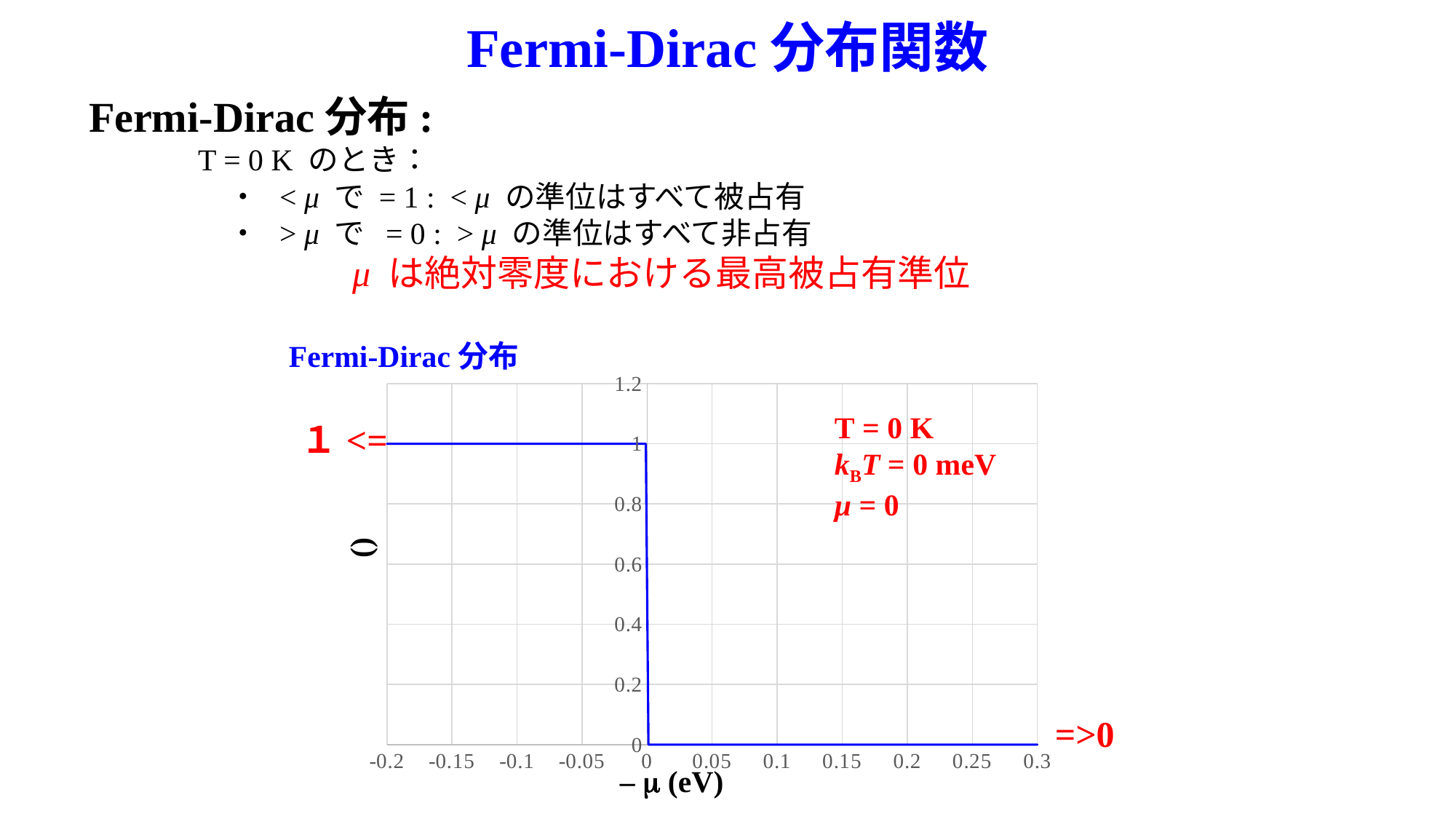
What kind of chart is shown on the slide? line chart What temperature is annotated on the chart? T = 0 K At what x value does the plotted function drop from 1 to 0? 0 What is the difference between the plotted value at x = -0.1 eV and at x = 0.25 eV? 1 What is the title of the chart? Fermi-Dirac 分布 Is the plotted value at x = 0.1 eV greater or less than 0.2? less Which is larger, the plotted value at x = -0.05 eV or at x = 0.05 eV? x = -0.05 eV Is the plotted value at x = -0.15 eV greater or less than 0.8? greater What is the value of the plotted function at x = -0.1 eV? 1 What is the value of the plotted function at x = 0.2 eV? 0 Does the plotted value rise or fall as x increases along the x axis? fall What is the highest tick value shown on the y axis? 1.2